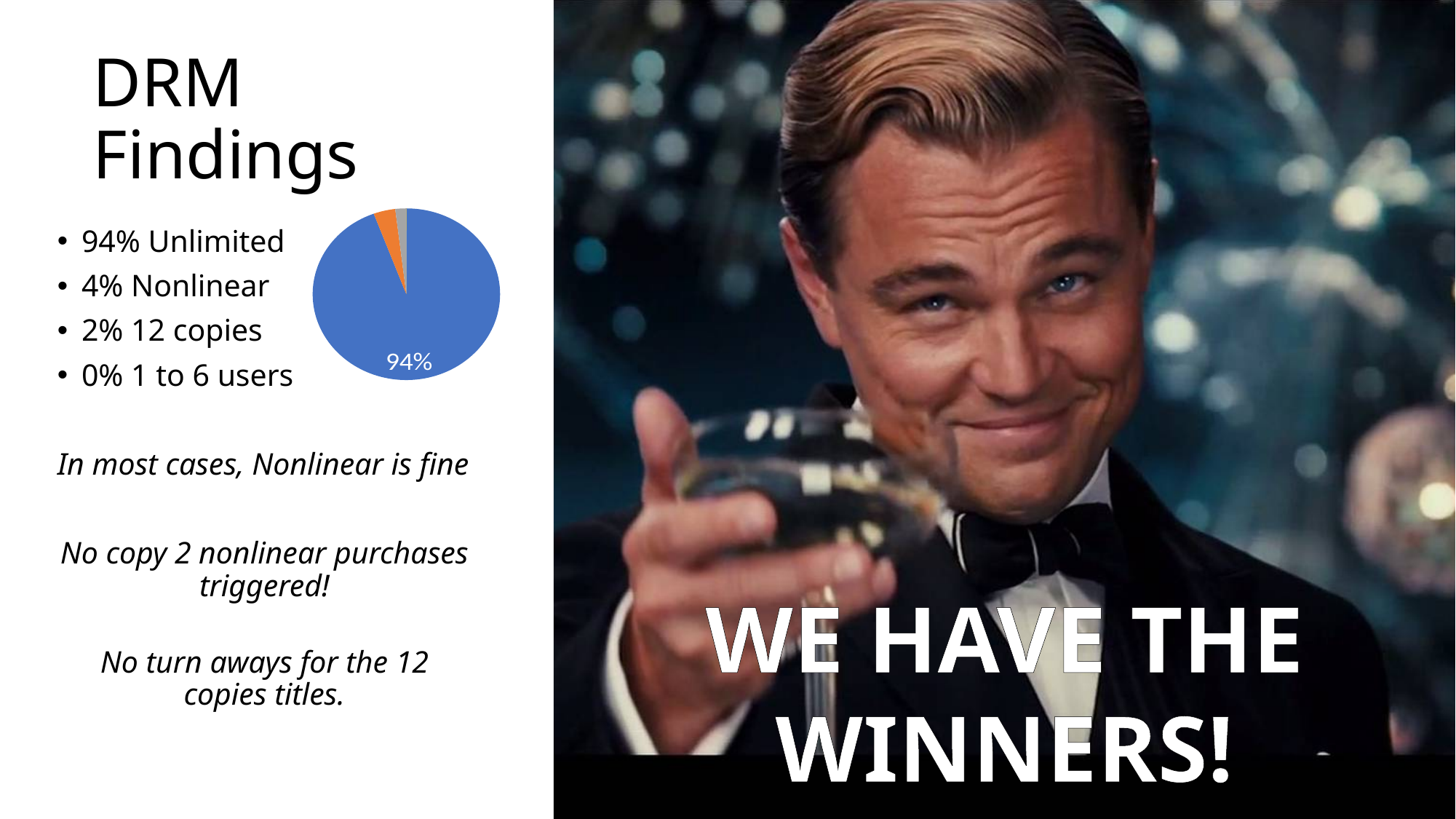
Which category does the largest slice of the pie chart represent? Unlimited Does the pie chart display a legend? No What share of the pie does the largest slice represent? 94% What is the difference in percentage points between the Unlimited share and the Nonlinear share? 90 percentage points Is the largest slice of the pie chart greater or less than 50%? greater What colour is the largest slice of the pie chart? blue What value is printed on the largest slice of the pie chart? 94% Which is larger in the pie chart, the orange slice or the grey slice? the orange slice What kind of chart is shown on the slide? pie chart